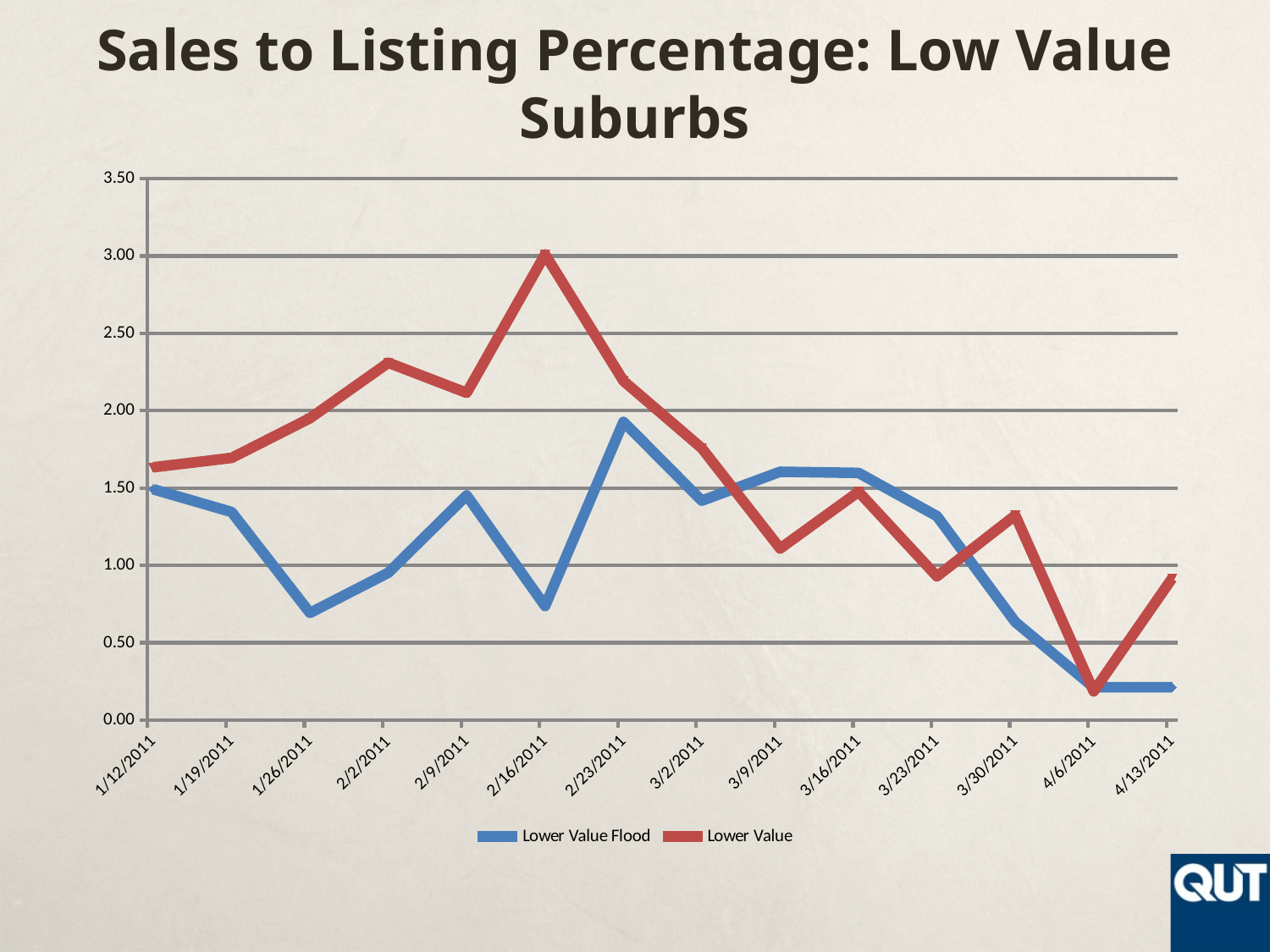
Is the value for Lower Value Flood on 4/13/2011 greater or less than 0.50? less How many dates are shown along the x axis? 14 Is the value for Lower Value on 2/2/2011 greater or less than 2.00? greater On 3/9/2011, which series has the higher value, Lower Value Flood or Lower Value? Lower Value Flood On 3/30/2011, which series has the higher value, Lower Value Flood or Lower Value? Lower Value How many series does the legend list? 2 On which date does the Lower Value series reach its lowest point? 4/6/2011 What kind of chart is shown on the slide? Line chart Does the Lower Value series rise or fall from 1/12/2011 to 2/16/2011? Rise On which date does the Lower Value Flood series reach its highest point? 2/23/2011 On which date does the Lower Value series reach its highest point? 2/16/2011 Is the value for Lower Value Flood on 1/26/2011 greater or less than 1.00? less